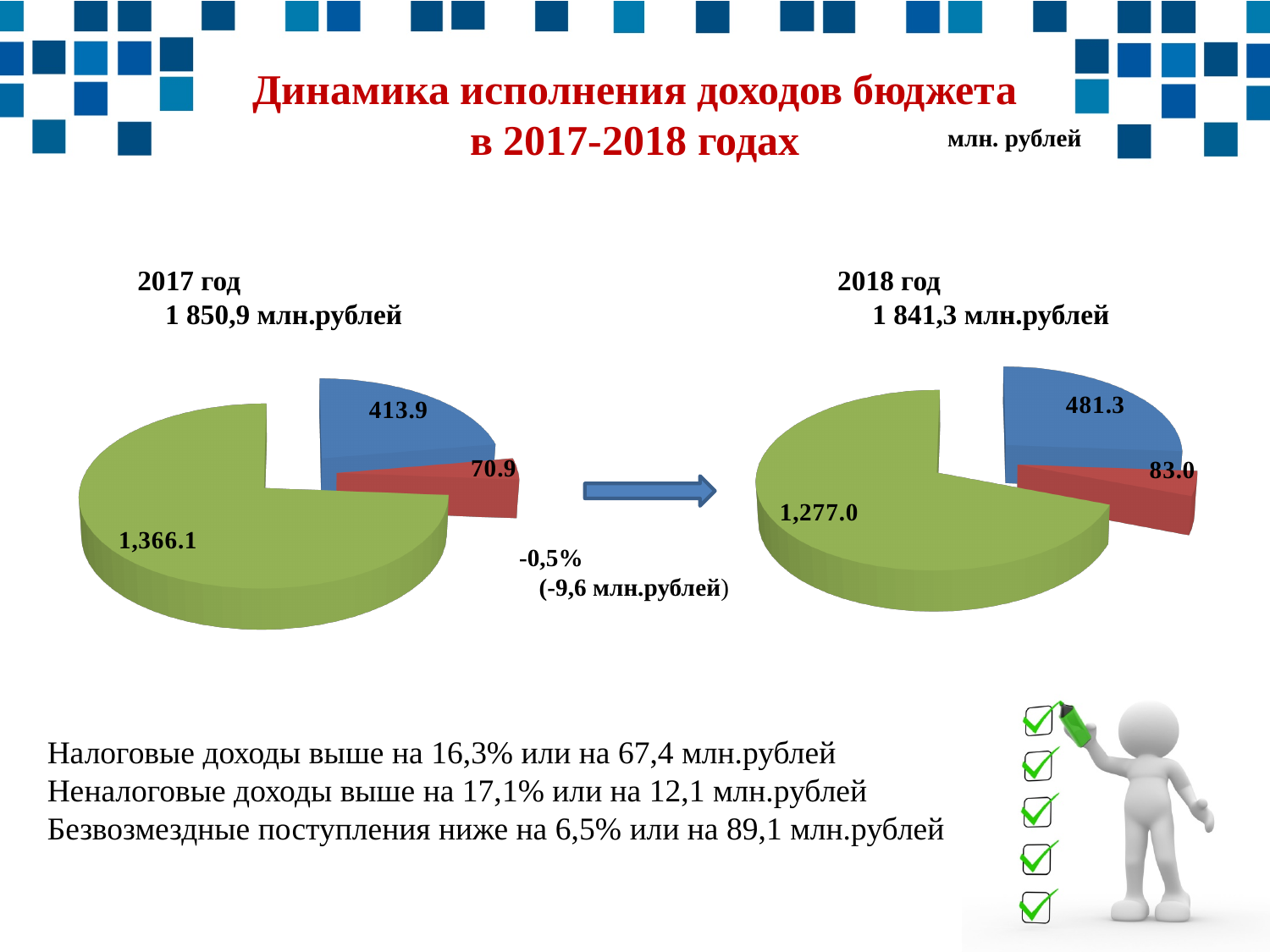
In the 2017 год pie chart, which slice is the smallest? The red slice (70.9) In the 2018 год pie chart, what is the value of the blue slice? 481.3 What is the difference between the blue slice in the 2018 год chart and the blue slice in the 2017 год chart? 67.4 How many slices does each pie chart have? 3 What type of charts are shown on the slide? Pie charts How many pie charts are on the slide? 2 In the 2018 год pie chart, what is the value of the red slice? 83.0 In the 2018 год pie chart, what is the value of the green slice? 1,277.0 In the 2018 год pie chart, which slice is the largest? The green slice (1,277.0) In the 2017 год pie chart, what is the value of the blue slice? 413.9 In the 2017 год pie chart, what is the value of the green slice? 1,366.1 In the 2017 год pie chart, what is the value of the red slice? 70.9